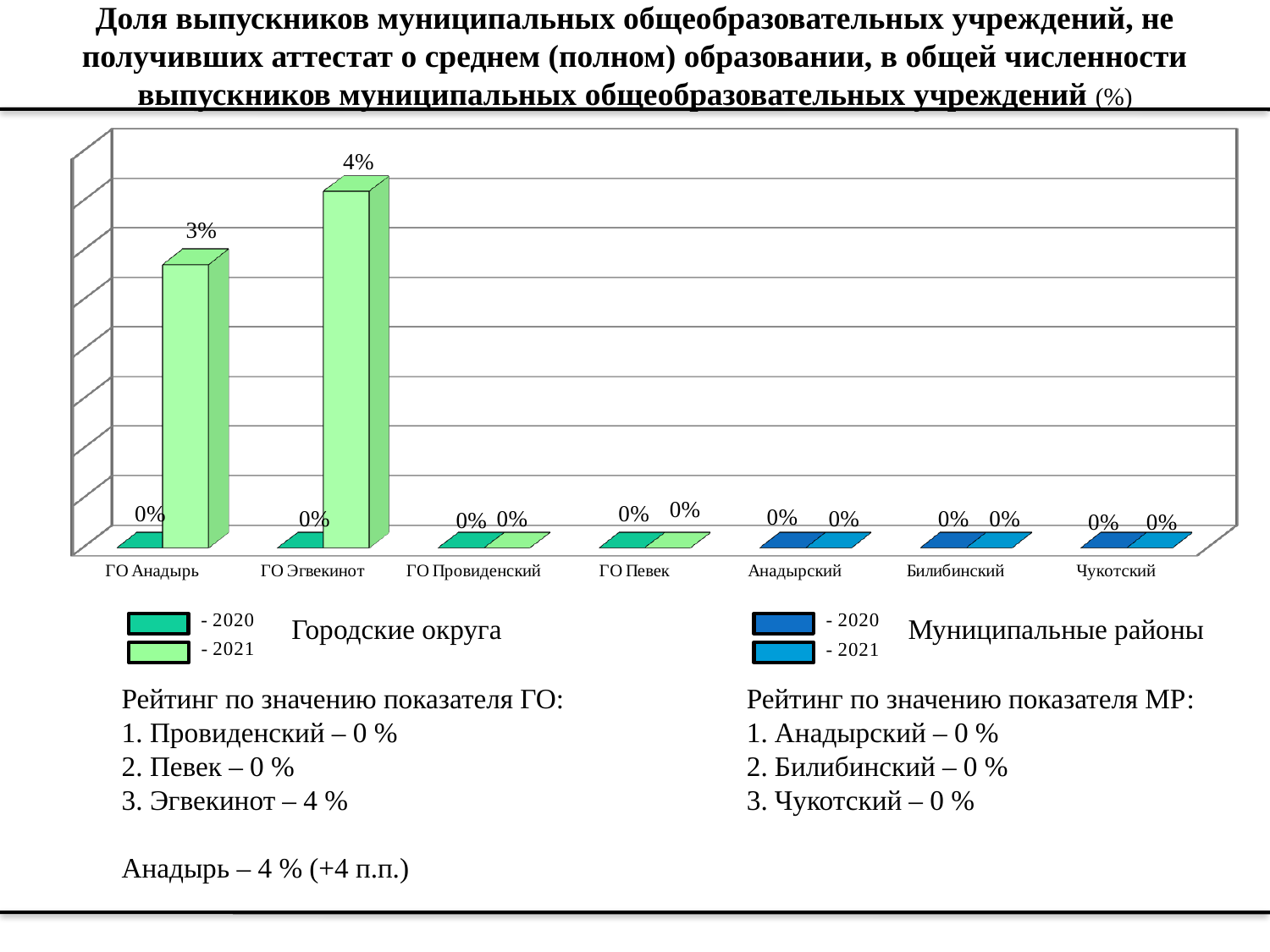
How many entries does the legend for Городские округа list? 2 Which is larger: the 2021 value for ГО Анадырь or the 2021 value for ГО Певек? ГО Анадырь What is the 2020 value for ГО Анадырь? 0% What kind of chart is shown on the slide? bar chart How many categories are shown on the x axis? 7 What is the 2021 value for ГО Эгвекинот? 4% What is the 2021 value for Билибинский? 0% Which category has the highest 2021 value? ГО Эгвекинот What is the difference between the 2021 values for ГО Эгвекинот and ГО Анадырь? 1% What is the 2021 value for ГО Анадырь? 3% Which years do the legend entries represent? 2020 and 2021 What is the difference between the 2021 and 2020 values for ГО Эгвекинот? 4%